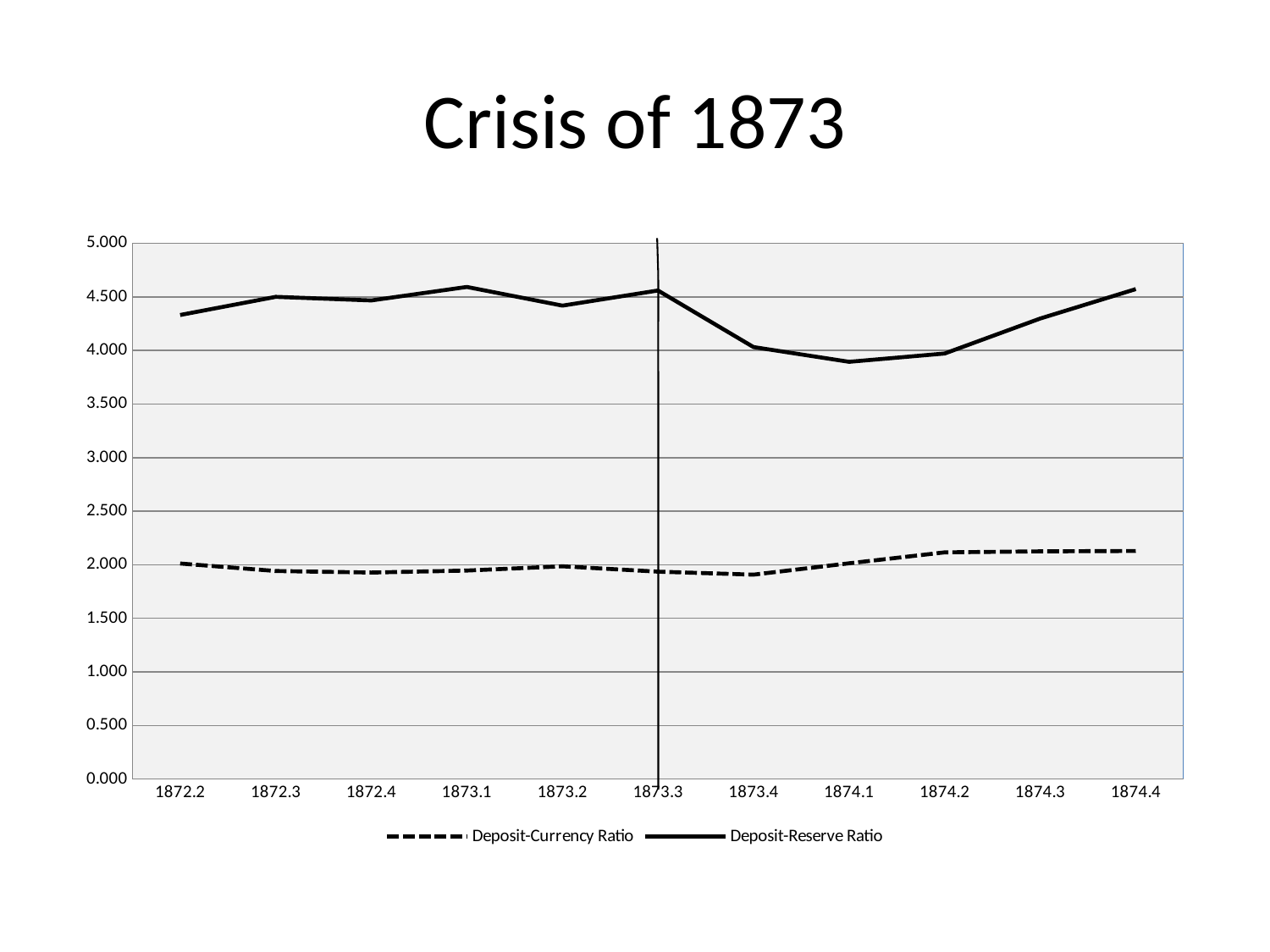
Does the Deposit-Currency Ratio rise or fall from 1873.4 to 1874.4? rise How many series does the legend list? 2 What is the title of the slide? Crisis of 1873 At 1873.3, which series has the higher value, Deposit-Currency Ratio or Deposit-Reserve Ratio? Deposit-Reserve Ratio Is the Deposit-Currency Ratio at 1874.4 greater or less than 2.000? greater Is the Deposit-Reserve Ratio at 1874.1 greater or less than 4.000? less How many time periods are shown on the x axis? 11 Is the Deposit-Reserve Ratio at 1872.2 greater or less than 4.000? greater What kind of chart is shown on the slide? line chart Which series is drawn with a dashed line? Deposit-Currency Ratio Does the Deposit-Reserve Ratio rise or fall from 1873.3 to 1874.1? fall